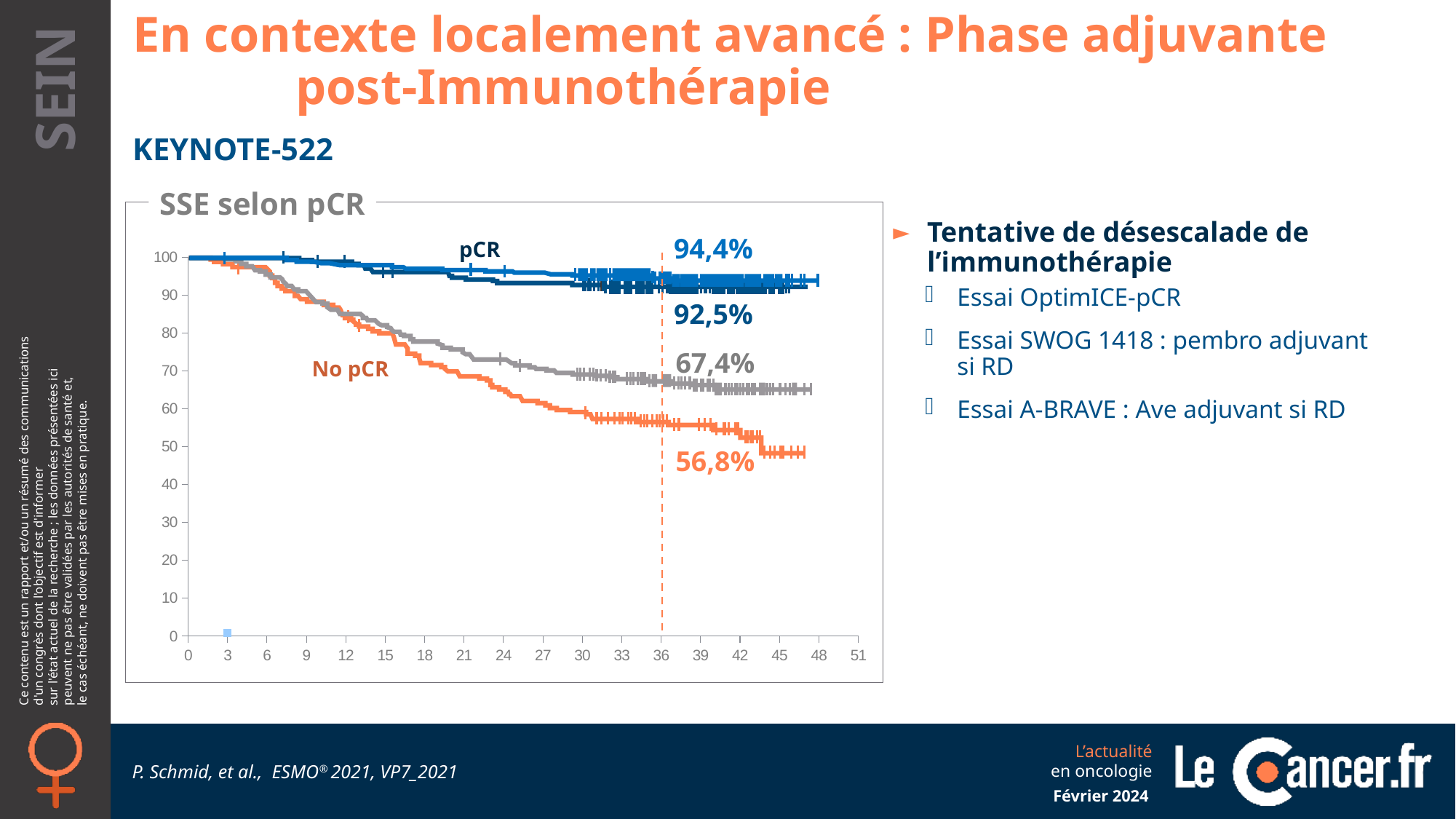
On the "SSE selon pCR" chart, at which x-axis value is the dashed vertical line drawn? 36 What is the difference between the grey curve's 67,4% and the orange curve's 56,8% on the "SSE selon pCR" chart? 10,6 points What is the lowest percentage printed on the "SSE selon pCR" chart? 56,8% What is the highest percentage printed on the "SSE selon pCR" chart? 94,4% What percentage is printed for the dark blue pCR curve on the "SSE selon pCR" chart? 92,5% On the "SSE selon pCR" chart, do the curves rise or fall as time increases along the x axis? Fall What is the difference between the two printed pCR percentages (94,4% and 92,5%) on the "SSE selon pCR" chart? 1,9 points What kind of chart is shown under the title "SSE selon pCR"? Line chart What percentage is printed for the orange "No pCR" curve on the "SSE selon pCR" chart? 56,8% On the "SSE selon pCR" chart, which group has higher values: pCR or No pCR? pCR How many curves are plotted on the "SSE selon pCR" chart? 4 What percentage is printed for the grey curve on the "SSE selon pCR" chart? 67,4%